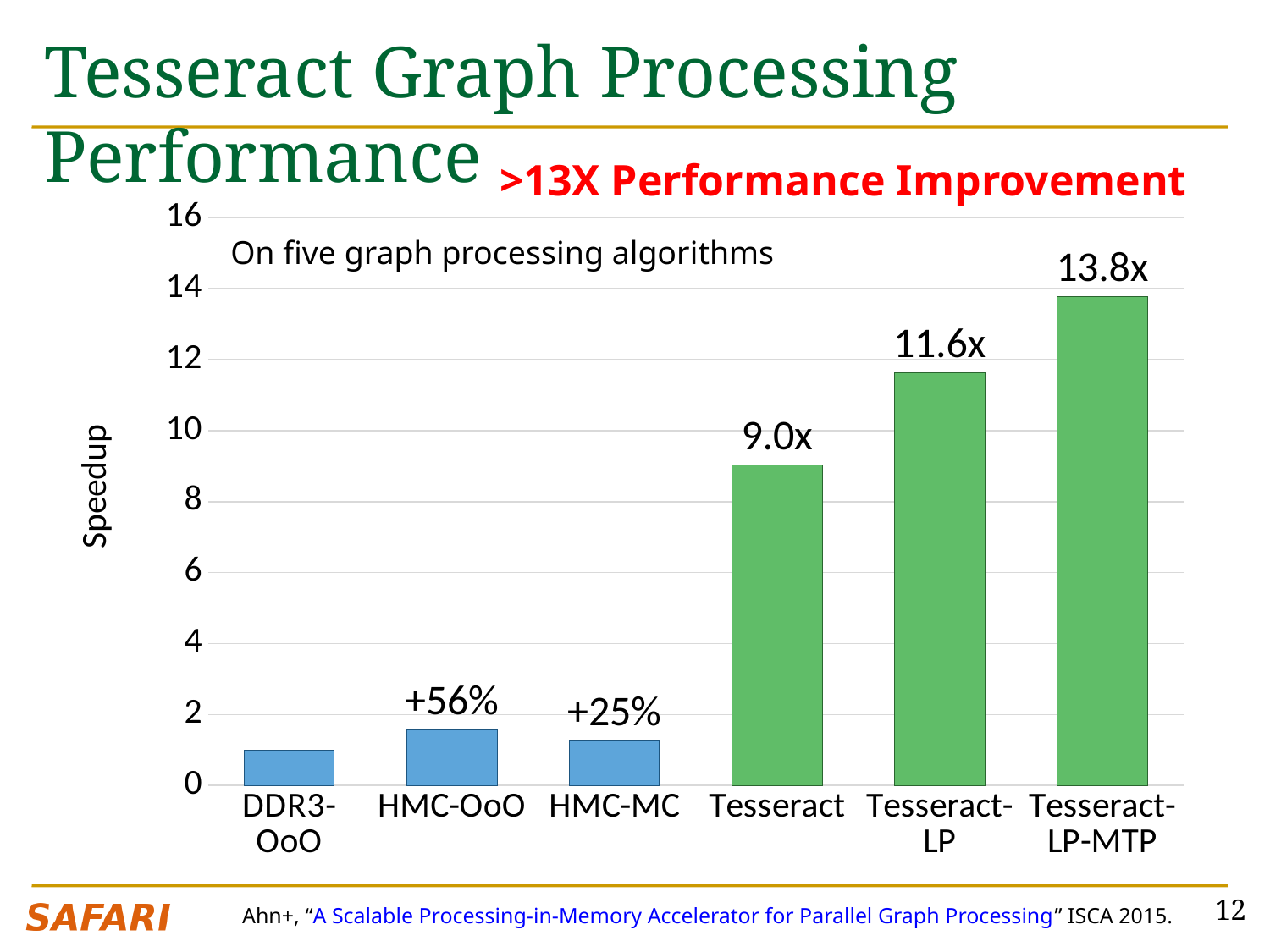
What is the difference in speedup between Tesseract-LP-MTP and Tesseract? 4.8x What is the speedup shown for Tesseract-LP-MTP? 13.8x Which has a larger speedup, HMC-OoO or Tesseract-LP? Tesseract-LP What label is printed above the HMC-MC bar? +25% Which category has the highest speedup? Tesseract-LP-MTP What kind of chart is shown on the slide? bar chart What is the speedup shown for Tesseract-LP? 11.6x What label is printed above the HMC-OoO bar? +56% What is the speedup shown for Tesseract? 9.0x Is the speedup for DDR3-OoO greater or less than 2? less Which category has the lowest speedup? DDR3-OoO How many categories are shown on the x axis? 6